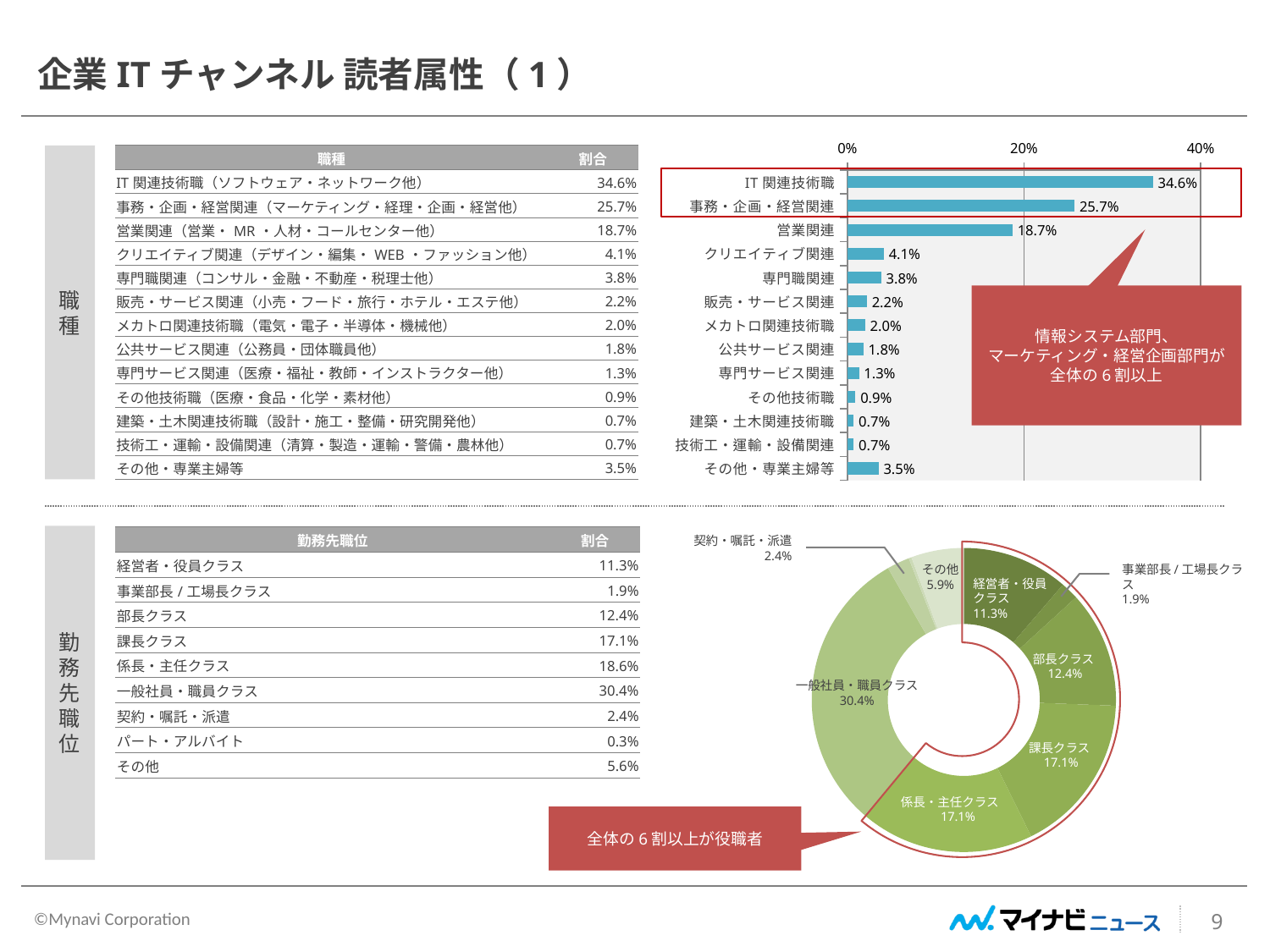
How many categories are shown in the upper bar chart (職種)? 13 What kind of chart is the upper chart (職種) on the slide? bar chart In the upper bar chart (職種), is the value for 事務・企画・経営関連 greater or less than 20%? greater In the upper bar chart (職種), which category has the highest value? IT関連技術職 In the lower donut chart (勤務先職位), what is the value for 部長クラス? 12.4% In the upper bar chart (職種), which is larger, クリエイティブ関連 or 専門職関連? クリエイティブ関連 In the upper bar chart (職種), what is the value for 営業関連? 18.7% In the lower donut chart (勤務先職位), which is larger, 経営者・役員クラス or 事業部長/工場長クラス? 経営者・役員クラス What kind of chart is the lower chart (勤務先職位) on the slide? donut chart In the upper bar chart (職種), what is the value for IT関連技術職? 34.6% In the upper bar chart (職種), what is the difference between IT関連技術職 and 事務・企画・経営関連? 8.9% In the lower donut chart (勤務先職位), what is the share for 一般社員・職員クラス? 30.4%